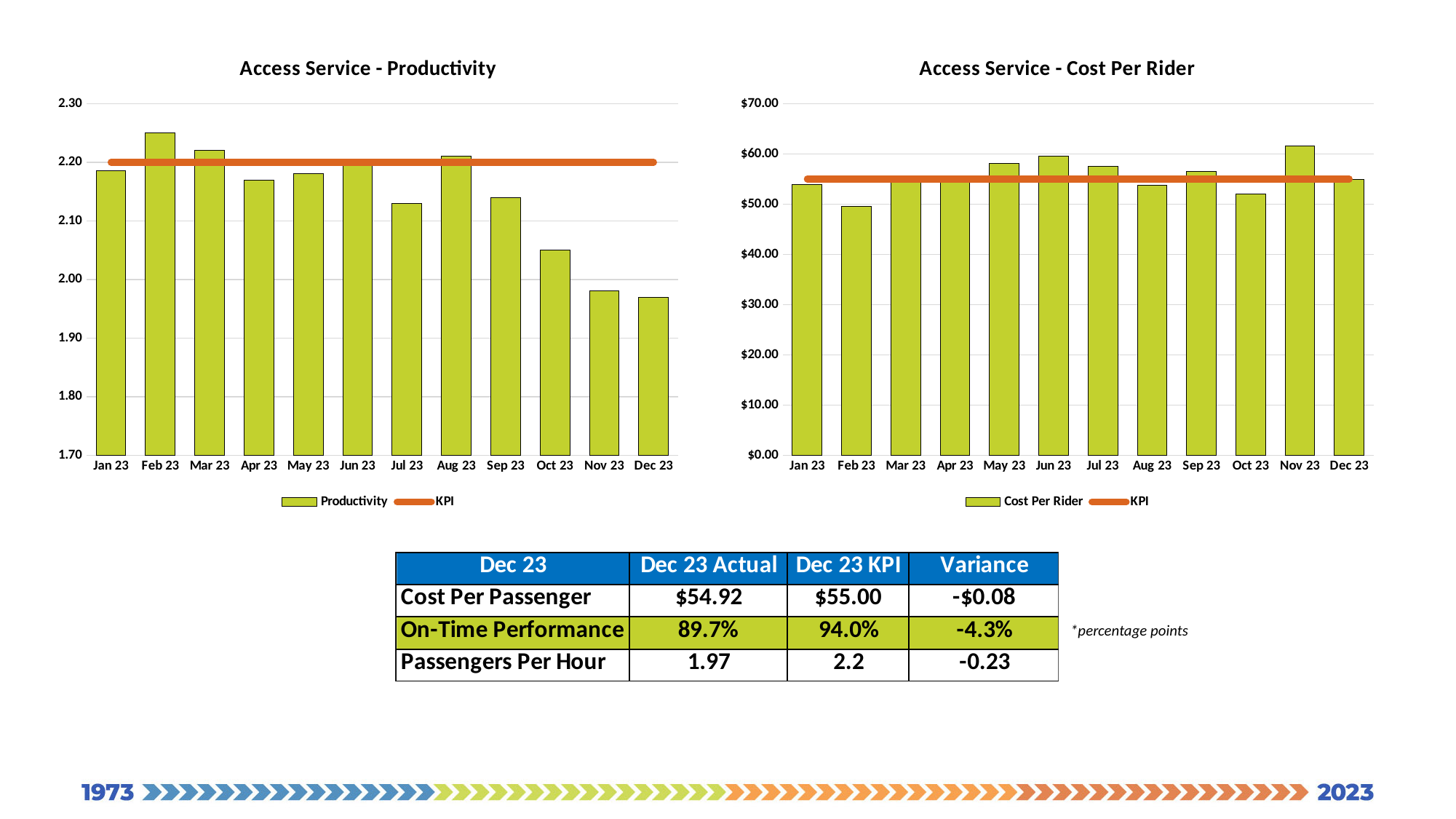
In the Access Service - Productivity chart, do the bars generally rise or fall from Jan 23 to Dec 23? Fall What kind of chart is the Access Service - Cost Per Rider chart? Combination bar and line chart In the Access Service - Productivity chart, is the value for Oct 23 greater or less than 2.10? less In the Access Service - Productivity chart, is the value for Nov 23 greater or less than 2.00? less In the Access Service - Cost Per Rider chart, which month has the highest cost per rider? Nov 23 In the Access Service - Productivity chart, which is larger, the value for Feb 23 or the value for Dec 23? Feb 23 In the Access Service - Cost Per Rider chart, which month has the lowest cost per rider? Feb 23 In the Access Service - Cost Per Rider chart, is the value for Nov 23 greater or less than $60.00? greater How many series does the legend of the Access Service - Productivity chart list? 2 How many months are plotted in the Access Service - Cost Per Rider chart? 12 In the Access Service - Productivity chart, which month has the highest productivity bar? Feb 23